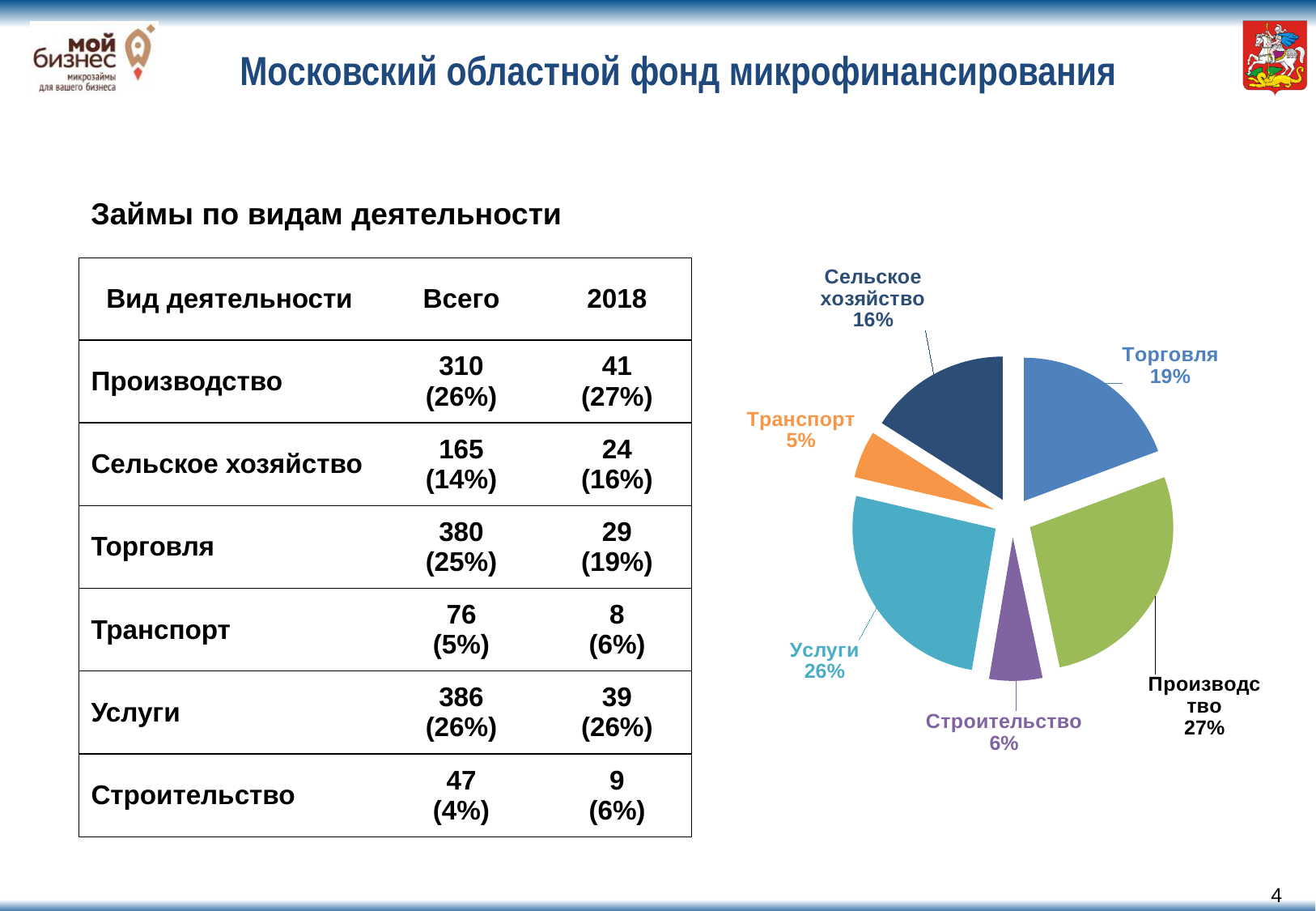
In the pie chart, which is larger: Торговля or Сельское хозяйство? Торговля What kind of chart is shown on the slide? pie chart What colour is the Транспорт slice in the pie chart? orange Which slice of the pie chart is the smallest? Транспорт In the pie chart, what share does Строительство have? 6% In the pie chart, what share does Услуги have? 26% Which slice of the pie chart is the largest? Производство In the pie chart, what share does Торговля have? 19% In the pie chart, what share does Транспорт have? 5% In the pie chart, what is the difference in percentage points between Производство and Услуги? 1 How many slices does the pie chart have? 6 In the pie chart, what share does Сельское хозяйство have? 16%